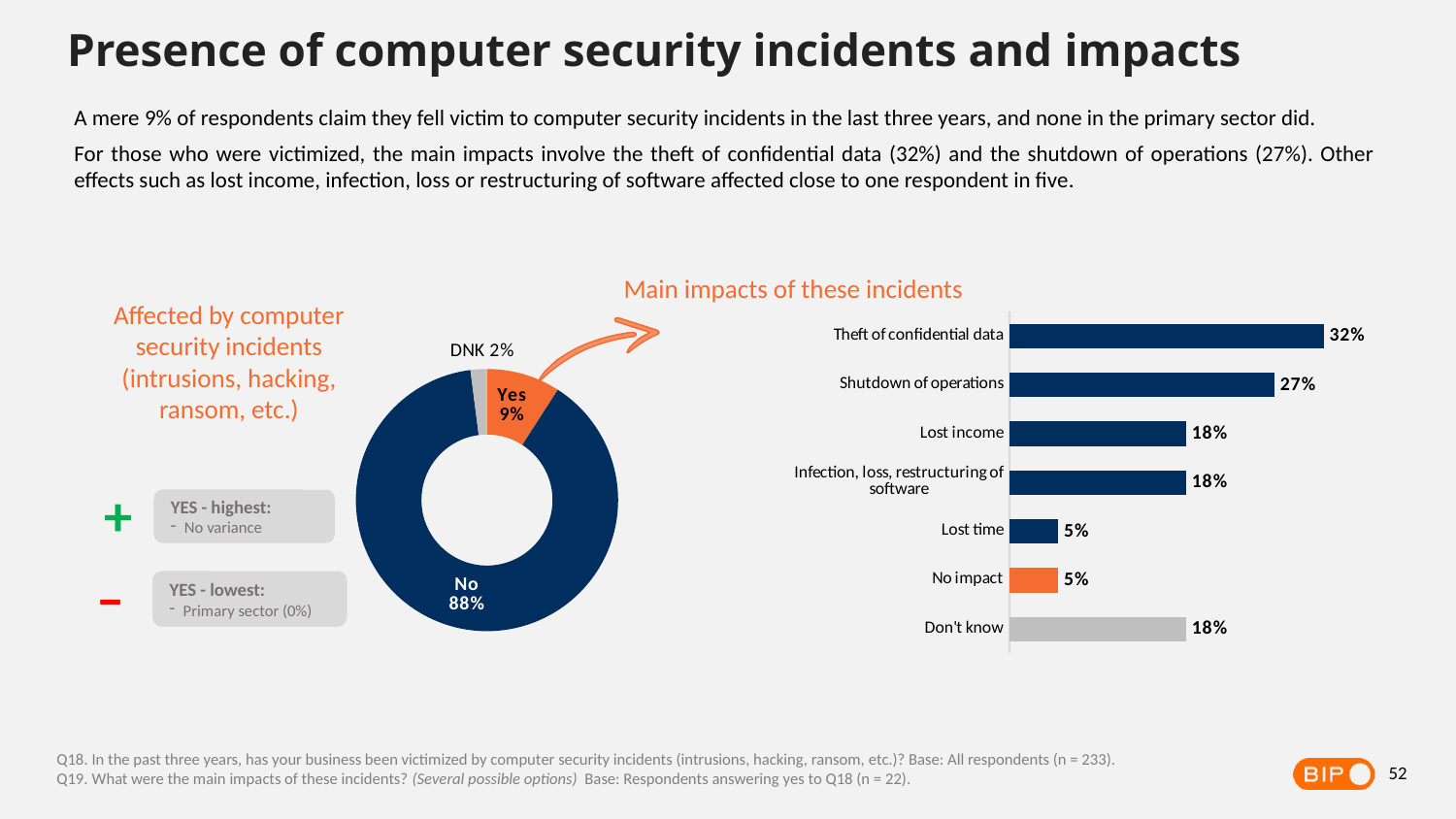
What kind of chart is the 'Main impacts of these incidents' chart? Bar chart In the 'Main impacts of these incidents' chart, what is the value for Shutdown of operations? 27% In the 'Affected by computer security incidents' chart, what share of respondents answered Yes? 9% In the 'Main impacts of these incidents' chart, what is the value for Don't know? 18% In the 'Affected by computer security incidents' chart, what share of respondents answered No? 88% In the 'Main impacts of these incidents' chart, which bar is shown in grey? Don't know In the 'Main impacts of these incidents' chart, which category has the highest value? Theft of confidential data How many categories are shown in the 'Main impacts of these incidents' chart? 7 In the 'Main impacts of these incidents' chart, what is the difference between Theft of confidential data and Shutdown of operations? 5 percentage points In the 'Affected by computer security incidents' chart, what share is DNK? 2% What kind of chart is the 'Affected by computer security incidents' chart? Doughnut chart In the 'Main impacts of these incidents' chart, which is larger: Lost income or Lost time? Lost income